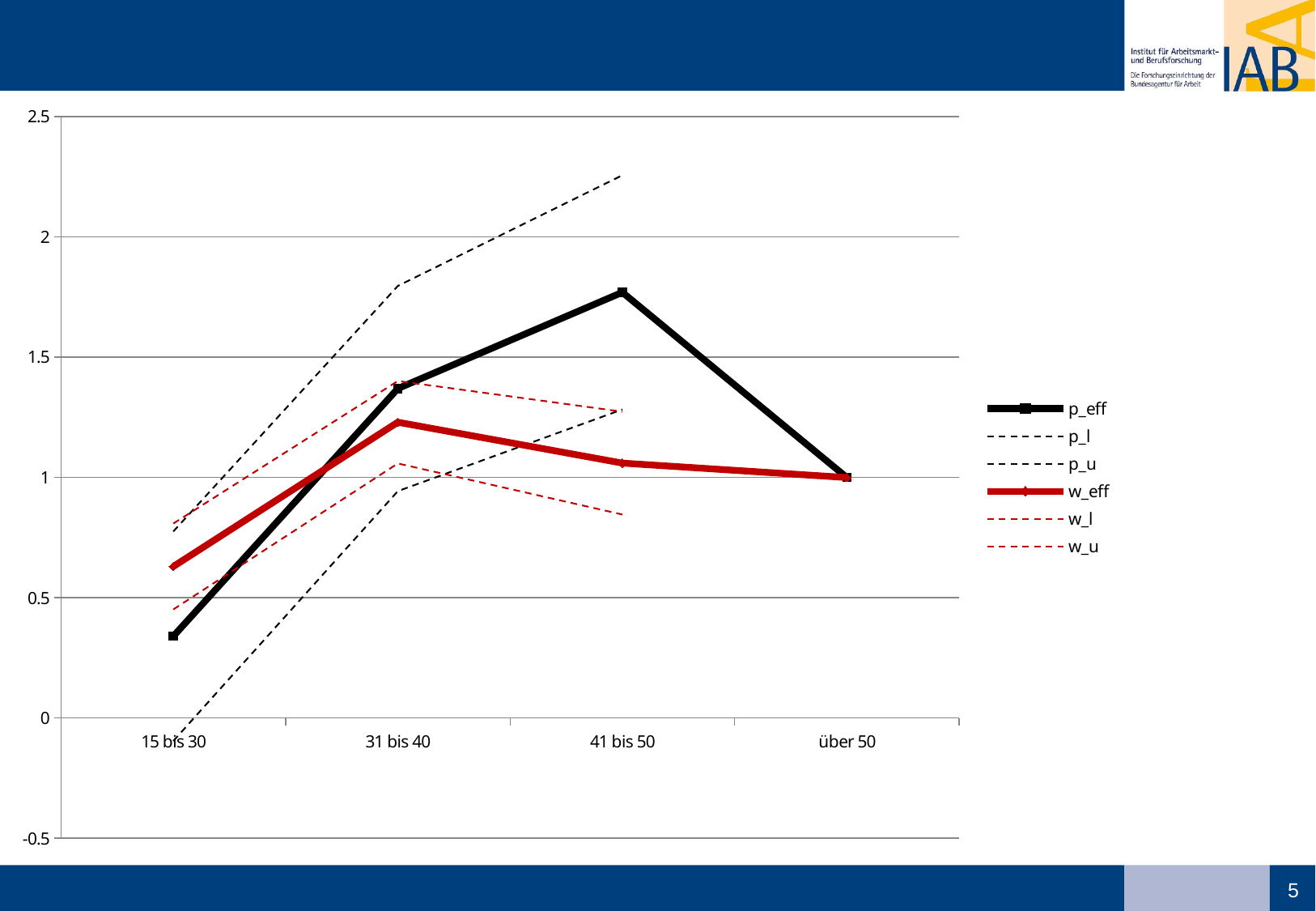
Does the p_u series rise or fall from 15 bis 30 to 41 bis 50? rise Which is larger at 15 bis 30: p_eff or w_eff? w_eff Which category has the lowest value for the p_eff series? 15 bis 30 What kind of chart is shown on the slide? line chart Which category has the highest value for the w_eff series? 31 bis 40 Is the value of w_eff for 15 bis 30 greater or less than 0.5? greater How many categories are shown on the x axis? 4 Is the value of p_eff for 41 bis 50 greater or less than 1.5? greater Is the value of p_eff for 15 bis 30 greater or less than 0.5? less How many series does the legend list? 6 Which is larger at 41 bis 50: p_eff or w_eff? p_eff Which category has the highest value for the p_eff series? 41 bis 50